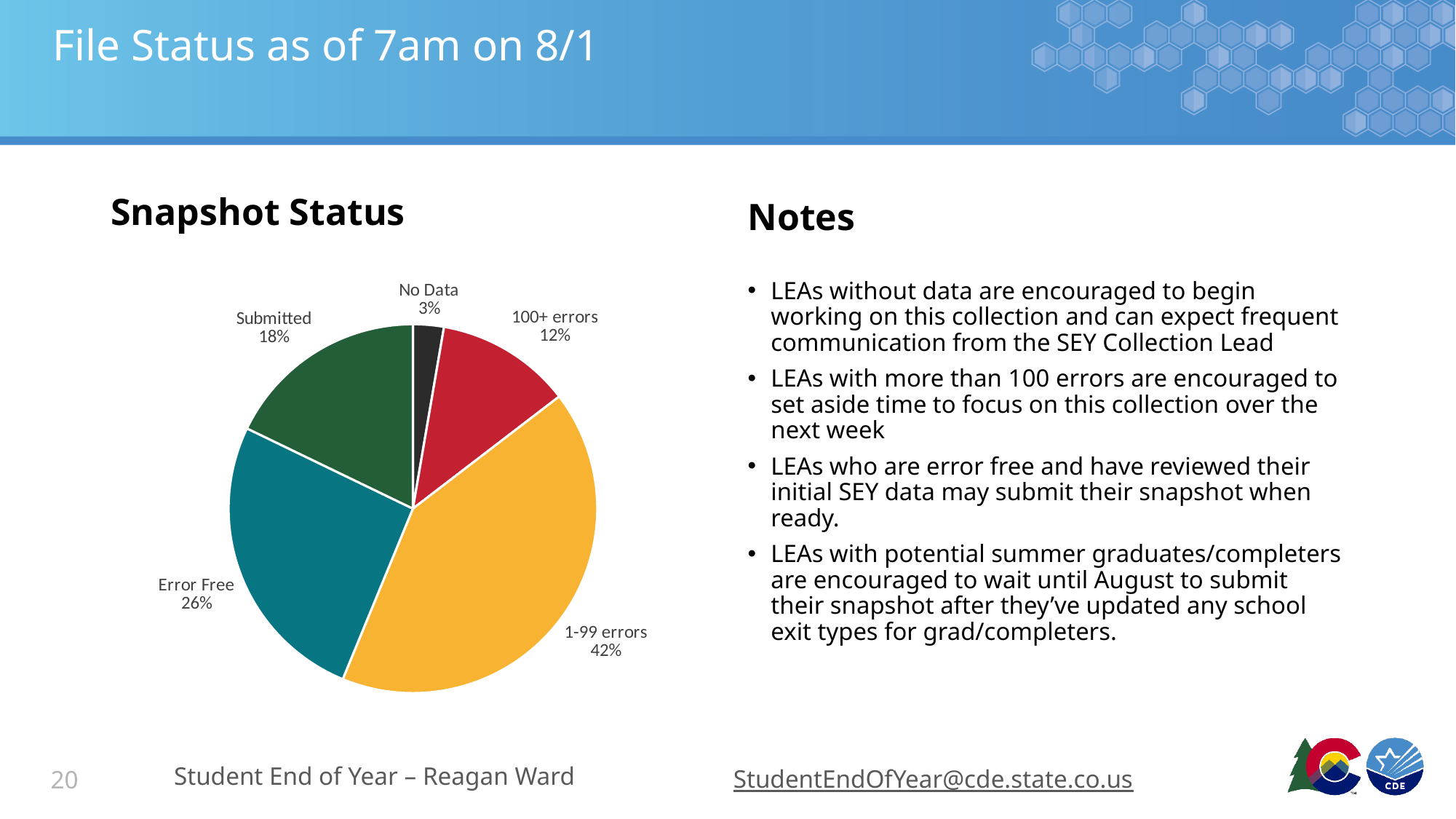
What type of chart is shown under the heading Snapshot Status? pie chart What colour is the 1-99 errors slice in the Snapshot Status pie chart? yellow/orange What percentage of the Snapshot Status pie is labelled 100+ errors? 12% What percentage of the Snapshot Status pie is labelled 1-99 errors? 42% In the Snapshot Status pie chart, what is the difference in percentage points between Error Free and Submitted? 8 In the Snapshot Status pie chart, which is larger: 100+ errors or Submitted? Submitted How many slices does the Snapshot Status pie chart have? 5 What percentage of the Snapshot Status pie is labelled Error Free? 26% What percentage of the Snapshot Status pie is labelled Submitted? 18% What percentage of the Snapshot Status pie is labelled No Data? 3% Which category has the largest slice in the Snapshot Status pie chart? 1-99 errors Which category has the smallest slice in the Snapshot Status pie chart? No Data